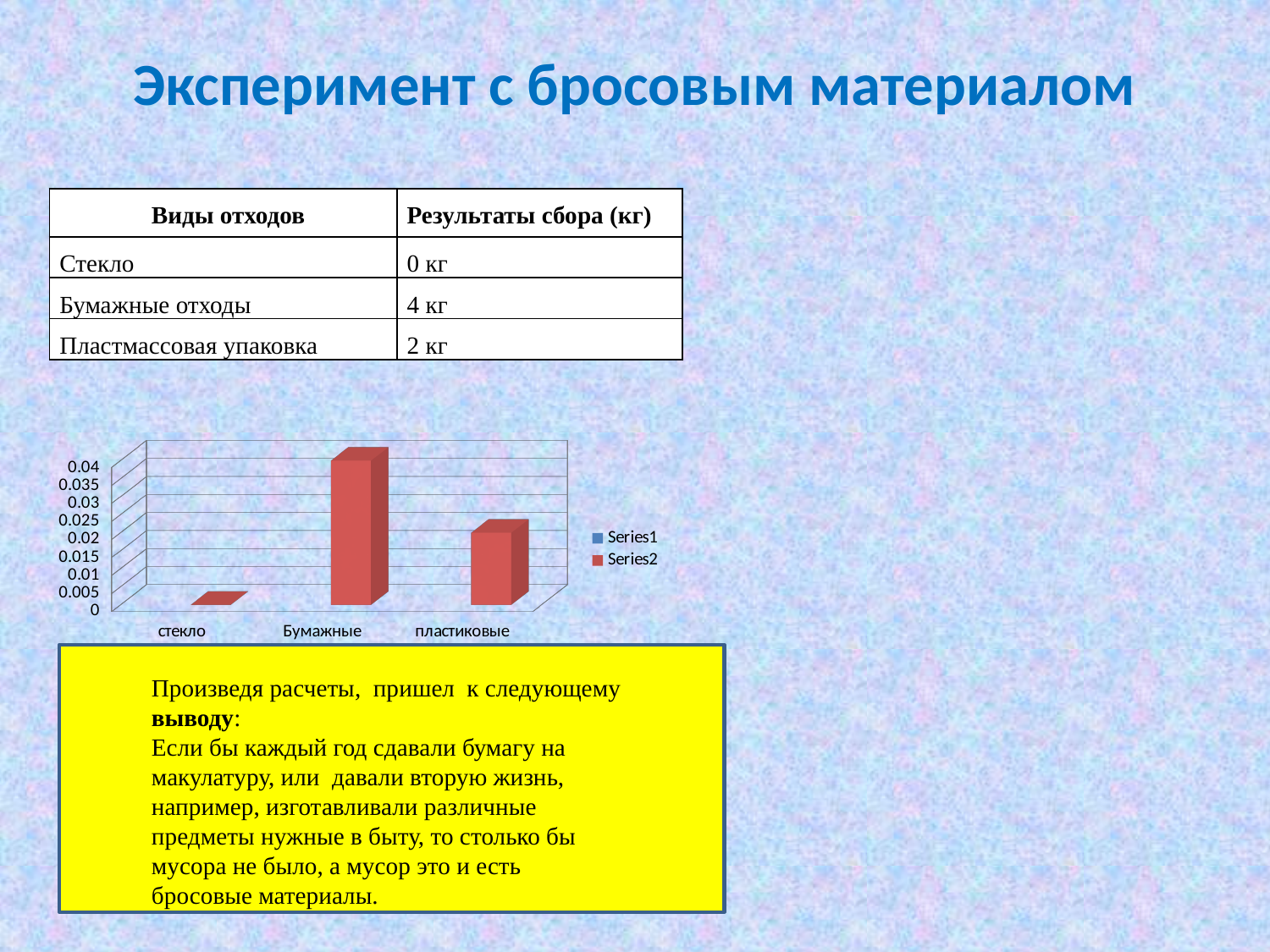
Is the value for пластиковые greater or less than 0.03? less What are the entries listed in the chart legend? Series1, Series2 Which is larger in the chart, the value for Бумажные or the value for пластиковые? Бумажные Which category has the highest bar in the chart? Бумажные Which category has the lowest bar in the chart? стекло Is the value for Бумажные greater or less than 0.03? greater How many categories are shown on the x axis of the chart? 3 Is the value for стекло greater or less than 0.005? less Do the values rise or fall from Бумажные to пластиковые along the x axis? fall How many series does the chart legend list? 2 What kind of chart is shown on the slide? bar chart